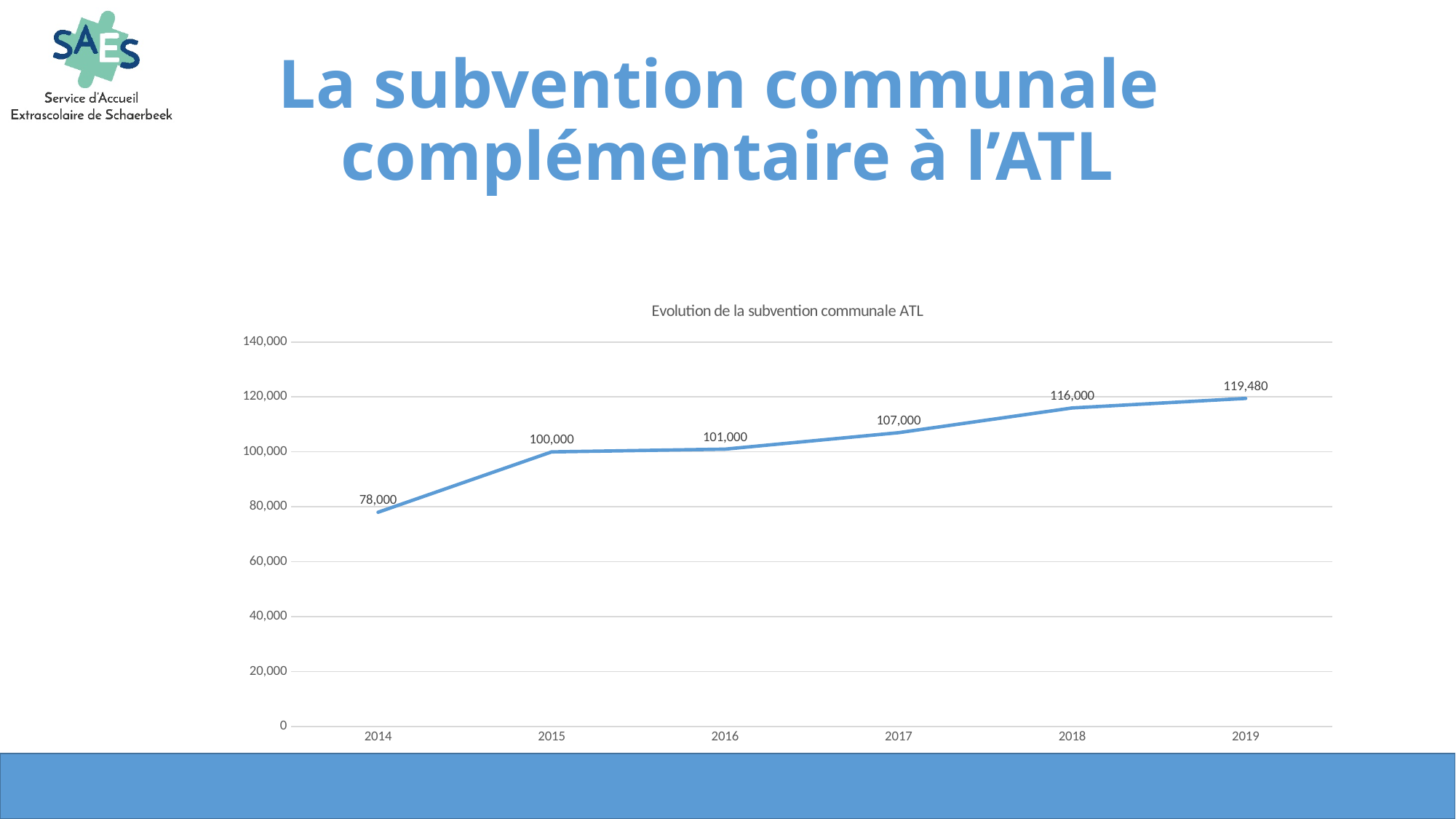
Which year has the highest value? 2019 What is the value for 2019? 119,480 Is the value for 2018 greater or less than 100,000? greater What is the value for 2014? 78,000 What is the difference between the values for 2018 and 2014? 38,000 Do the values rise or fall from 2014 to 2019? rise What is the value for 2017? 107,000 Which is larger, the value for 2017 or the value for 2016? 2017 Which year has the lowest value? 2014 What kind of chart is shown? line chart What is the difference between the values for 2016 and 2015? 1,000 How many years are plotted on the x axis? 6